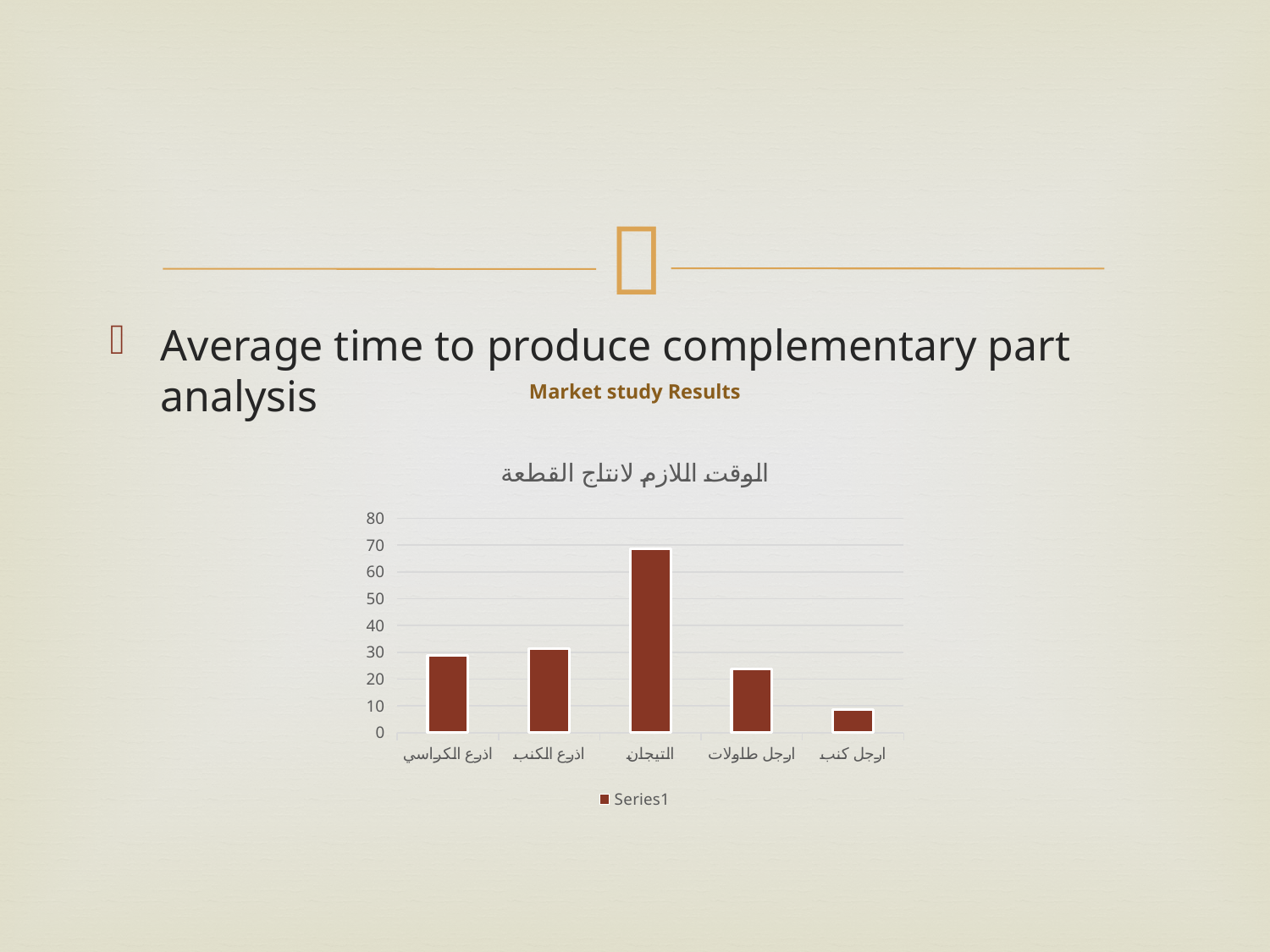
What is the name of the series shown in the chart legend? Series1 How many categories are plotted on the x axis of the chart? 5 Which category has the highest value in the chart? التيجان What kind of chart is shown on the slide? bar chart Is the value for ارجل طاولات greater or less than 30? less Which is larger, the value for التيجان or the value for ارجل طاولات? التيجان Which category has the lowest value in the chart? ارجل كنب How many series does the chart legend list? 1 Which is larger, the value for اذرع الكراسي or the value for ارجل كنب? اذرع الكراسي Is the value for ارجل كنب greater or less than 10? less What is the title of the chart? الوقت اللازم لانتاج القطعة Is the value for التيجان greater or less than 60? greater